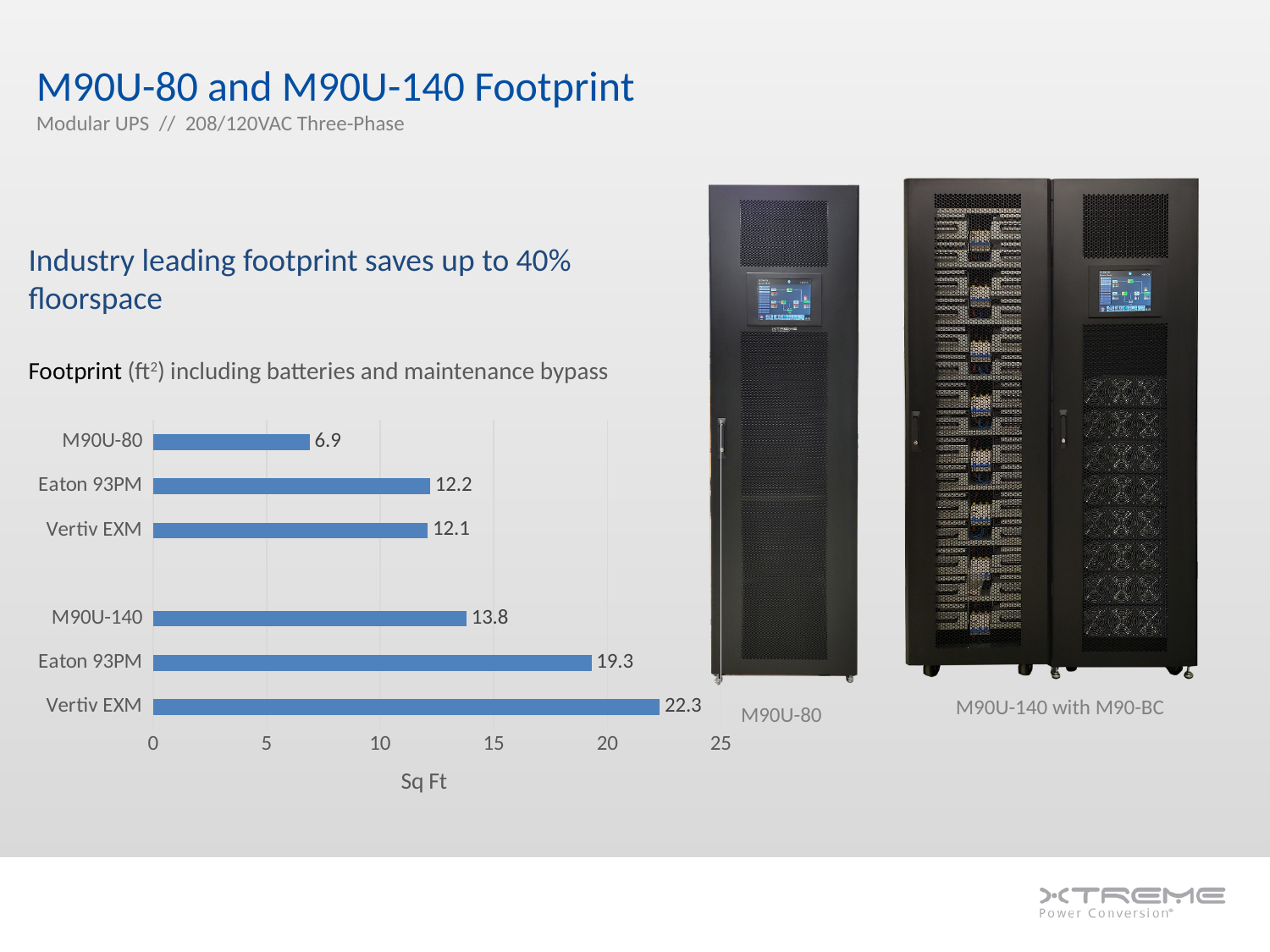
Which is larger, the value for M90U-140 or the value for Eaton 93PM in the lower group? Eaton 93PM Is the value for M90U-140 greater or less than 15? less How much larger is the Eaton 93PM value in the upper group than the M90U-80 value? 5.3 Which bar has the smallest value in the chart? M90U-80 What is the value for Eaton 93PM in the upper group of bars (the M90U-80 comparison)? 12.2 Which bar has the largest value in the chart? Vertiv EXM (lower group) What is the value for Vertiv EXM in the lower group of bars (the M90U-140 comparison)? 22.3 What is the label on the horizontal axis of the chart? Sq Ft What is the difference between the Vertiv EXM value in the lower group and the M90U-140 value? 8.5 How many bars are plotted in the chart? 6 What is the footprint value shown for M90U-140? 13.8 What is the footprint value shown for M90U-80? 6.9